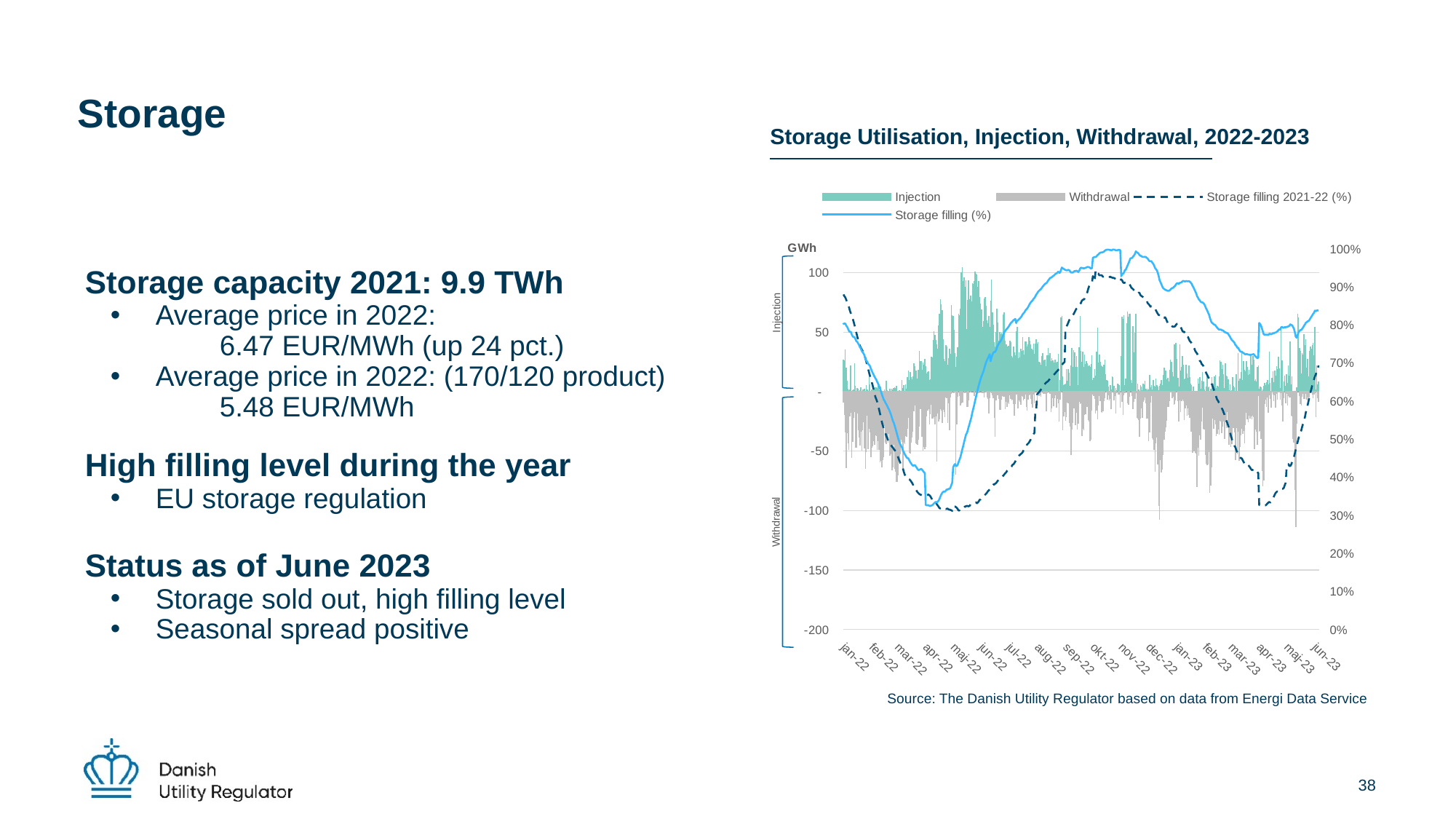
Is the peak value of the Storage filling (%) line around Oct-22 greater or less than 90%? greater Is the lowest value of the Storage filling 2021-22 (%) line, around May-22, greater or less than 40%? less Does the Storage filling (%) line rise or fall between Apr-22 and Oct-22? rise Which series in the chart is drawn as a dashed line? Storage filling 2021-22 (%) What is the highest value shown on the right-hand percentage axis of the chart? 100% Does the Storage filling 2021-22 (%) line rise or fall between Oct-22 and Mar-23? fall What is the title of the chart on the slide? Storage Utilisation, Injection, Withdrawal, 2022-2023 What is the lowest value shown on the left-hand GWh axis of the chart? -200 What kind of chart is shown on the slide? Combination chart of bars and lines Is the lowest value of the Storage filling (%) line, around Apr-22, greater or less than 50%? less How many series does the chart's legend list? 4 Is the Storage filling (%) value in Jan-23 greater or less than the Storage filling 2021-22 (%) value in Jan-23? greater